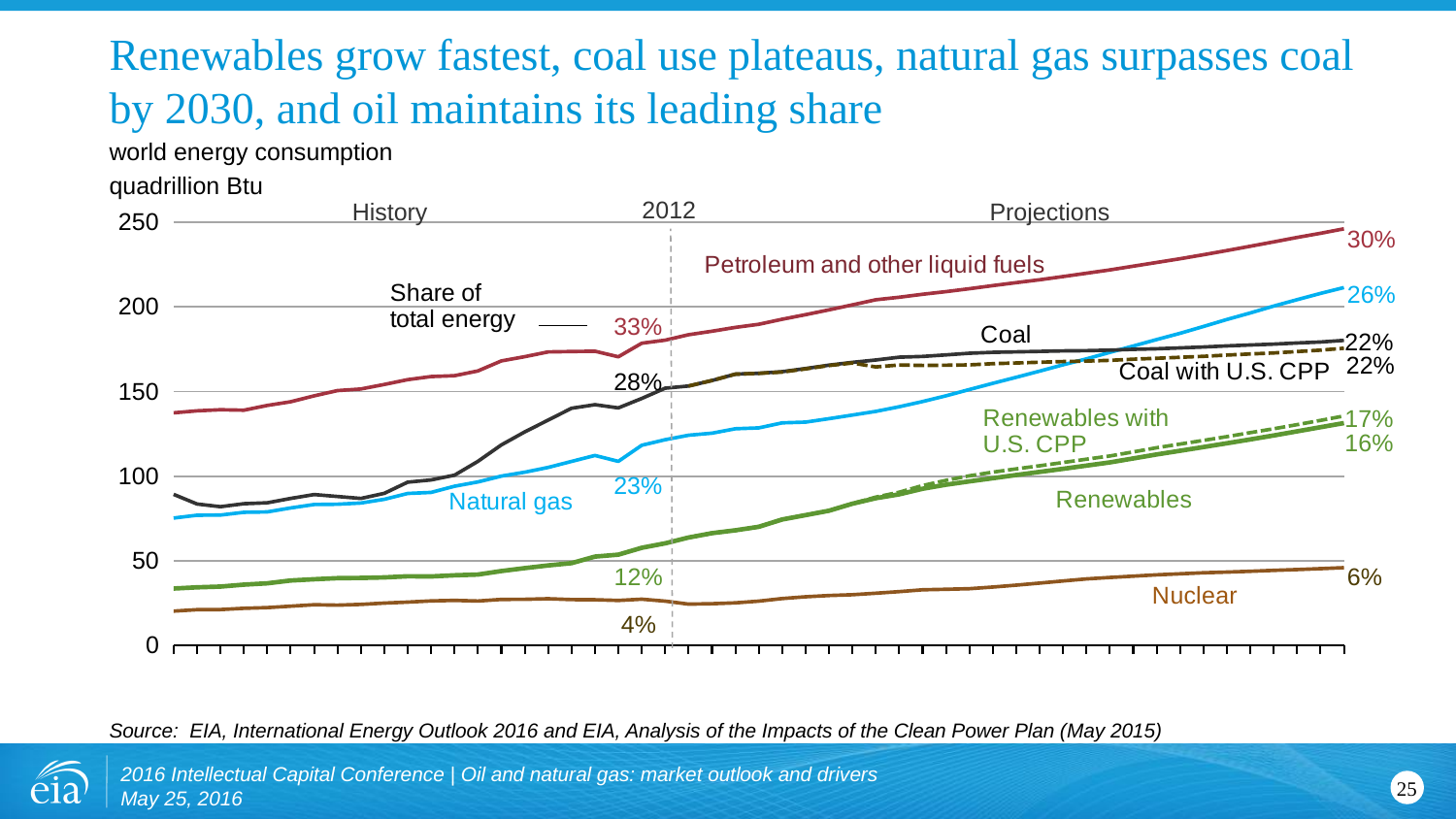
Which fuel has the lowest consumption throughout the chart? Nuclear Is the consumption of renewables at the start of the history period greater or less than 50 quadrillion Btu? less Which fuel has the highest consumption at the end of the projection period? Petroleum and other liquid fuels What share of total energy does natural gas have in 2012? 23% Is the consumption of petroleum and other liquid fuels at the end of the projection period greater or less than 200 quadrillion Btu? greater Does natural gas consumption rise or fall over the projection period? rise What share of total energy does coal have in 2012? 28% What share of total energy does nuclear have at the end of the projection period? 6% What share of total energy do renewables with U.S. CPP have at the end of the projection period? 17% What share of total energy does petroleum and other liquid fuels have in 2012? 33% What unit is used on the y axis of the chart? quadrillion Btu What kind of chart is shown on the slide? line chart